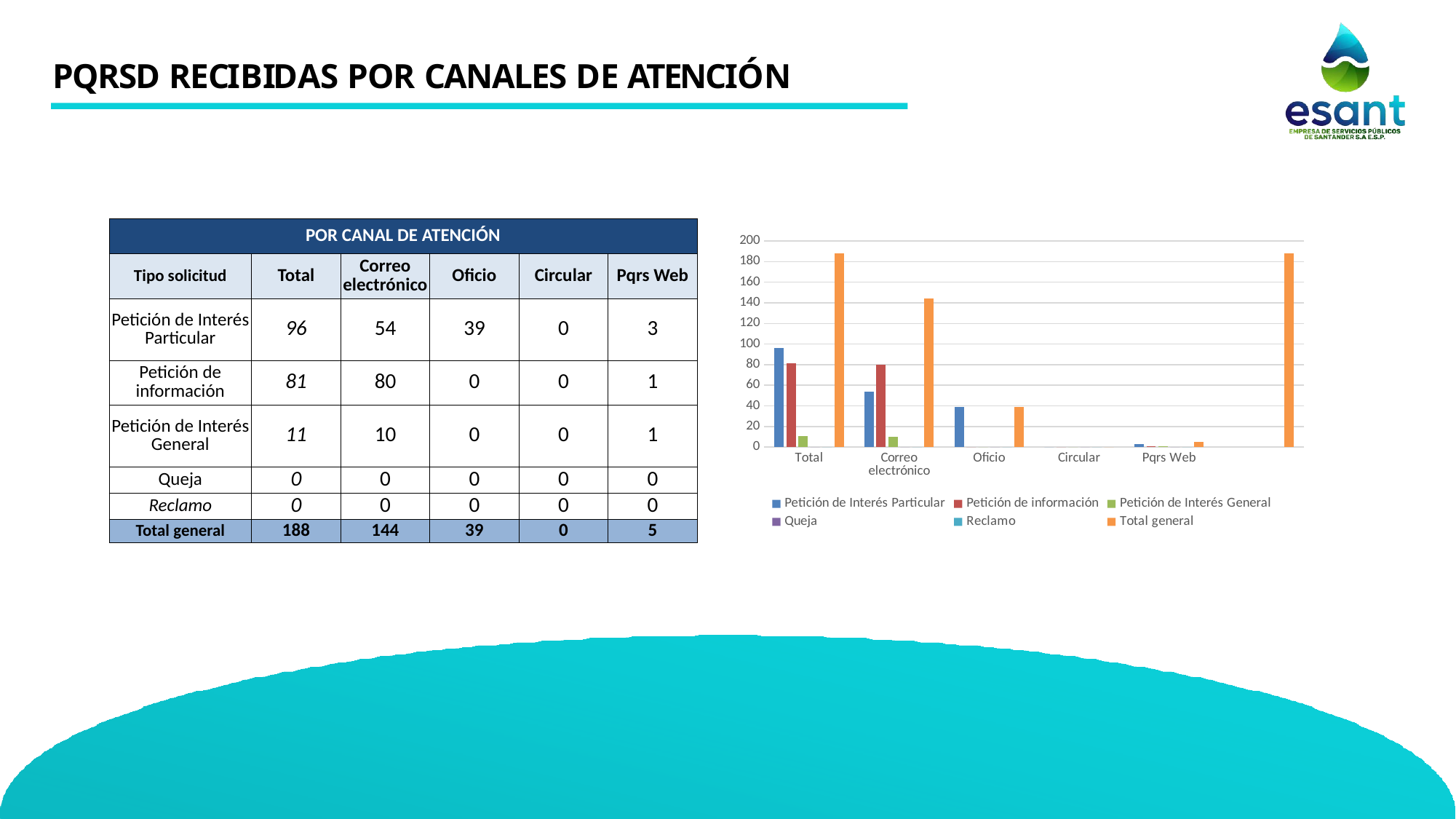
In the chart, is the Total general bar for the Total category greater or less than 180? greater What kind of chart is shown on the right of the slide? bar chart In the chart, which series has the tallest bar in the Correo electrónico category? Total general What colour represents the Total general series in the chart? orange In the chart, is the Petición de Interés Particular bar for the Total category greater or less than 80? greater In the chart, which is larger for Correo electrónico: Petición de información or Petición de Interés Particular? Petición de información In the chart, is the Total general bar for Oficio greater or less than 60? less How many series does the chart legend list? 6 What colour represents the Petición de Interés Particular series in the chart? blue In the chart, which is larger for the Total category: the Total general bar or the Petición de Interés Particular bar? Total general